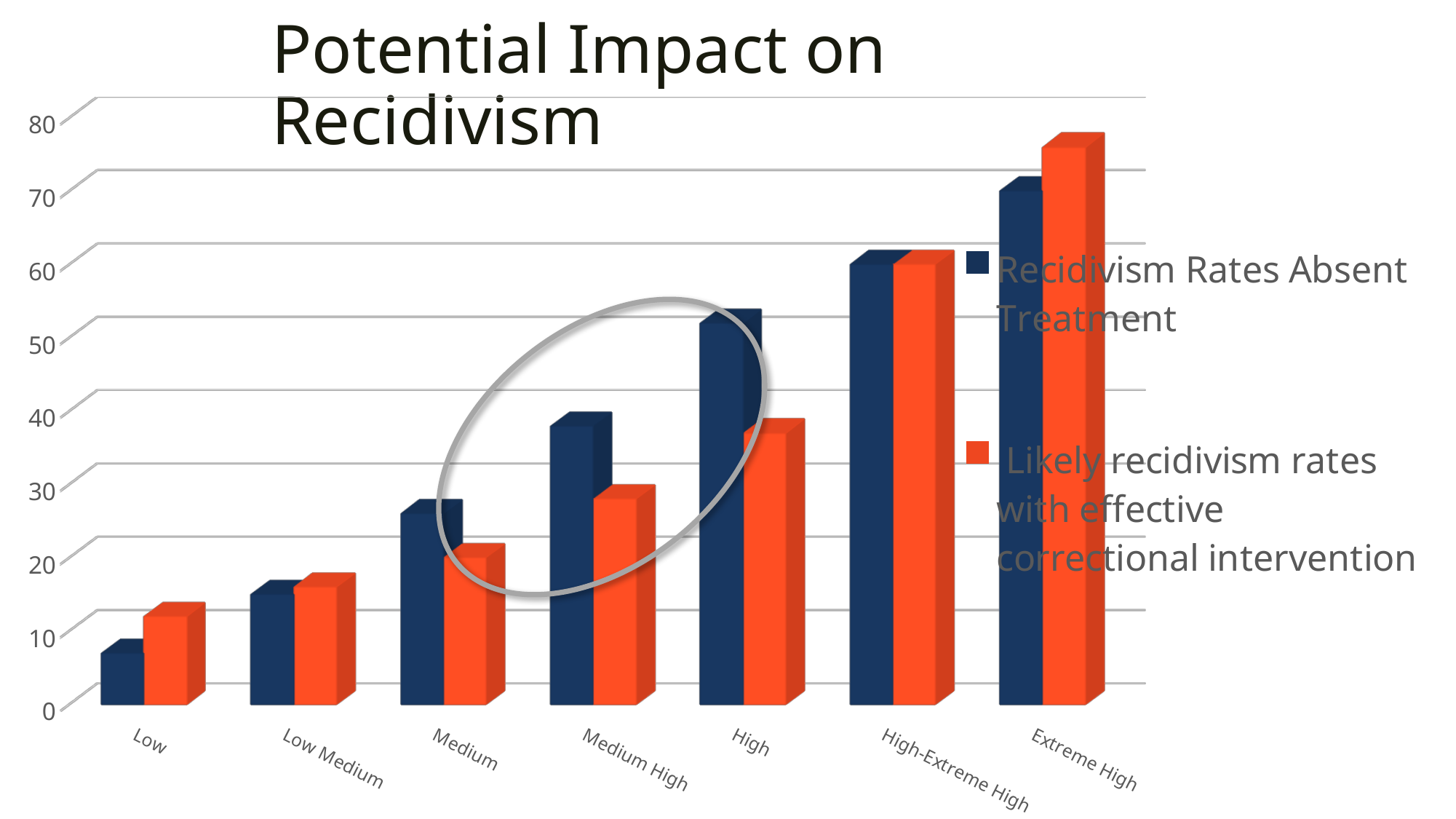
Is the value for Recidivism Rates Absent Treatment in the Low category greater or less than 10? less For the Medium High category, which series has the larger value: Recidivism Rates Absent Treatment or Likely recidivism rates with effective correctional intervention? Recidivism Rates Absent Treatment Which category has the highest value for Recidivism Rates Absent Treatment? Extreme High Which category has the lowest value for Likely recidivism rates with effective correctional intervention? Low How many risk categories are shown along the x axis? 7 What is the title of the chart? Potential Impact on Recidivism How many series does the legend list? 2 For the Low category, which series has the larger value: Recidivism Rates Absent Treatment or Likely recidivism rates with effective correctional intervention? Likely recidivism rates with effective correctional intervention Do the values for Recidivism Rates Absent Treatment rise or fall as the categories move from Low to Extreme High? rise Is the value for Recidivism Rates Absent Treatment in the Medium High category greater or less than 30? greater Is the value for Likely recidivism rates with effective correctional intervention in the Extreme High category greater or less than 70? greater What kind of chart is shown on the slide? bar chart